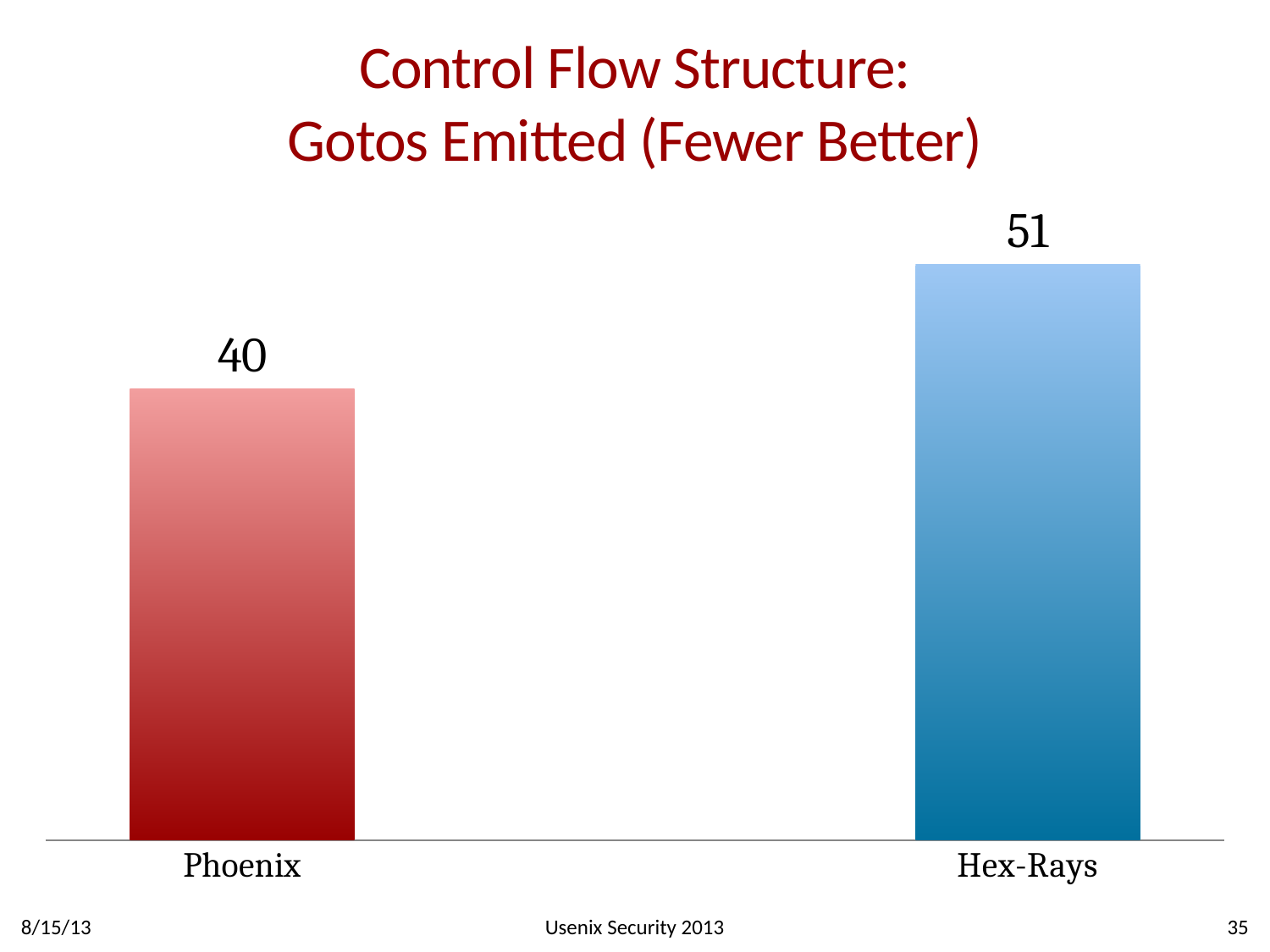
What is the title of the chart on the slide? Control Flow Structure: Gotos Emitted (Fewer Better) Which tool emitted the fewest gotos? Phoenix What colour is the bar for Phoenix? Red How many gotos were emitted by Phoenix? 40 What kind of chart is shown on the slide? Bar chart Which tool emitted the most gotos? Hex-Rays How many gotos were emitted by Hex-Rays? 51 How many tools are compared in the chart? 2 According to the chart title, is a lower or higher number of gotos better? Fewer (lower) is better Which emitted more gotos, Phoenix or Hex-Rays? Hex-Rays What is the difference between the number of gotos emitted by Hex-Rays and by Phoenix? 11